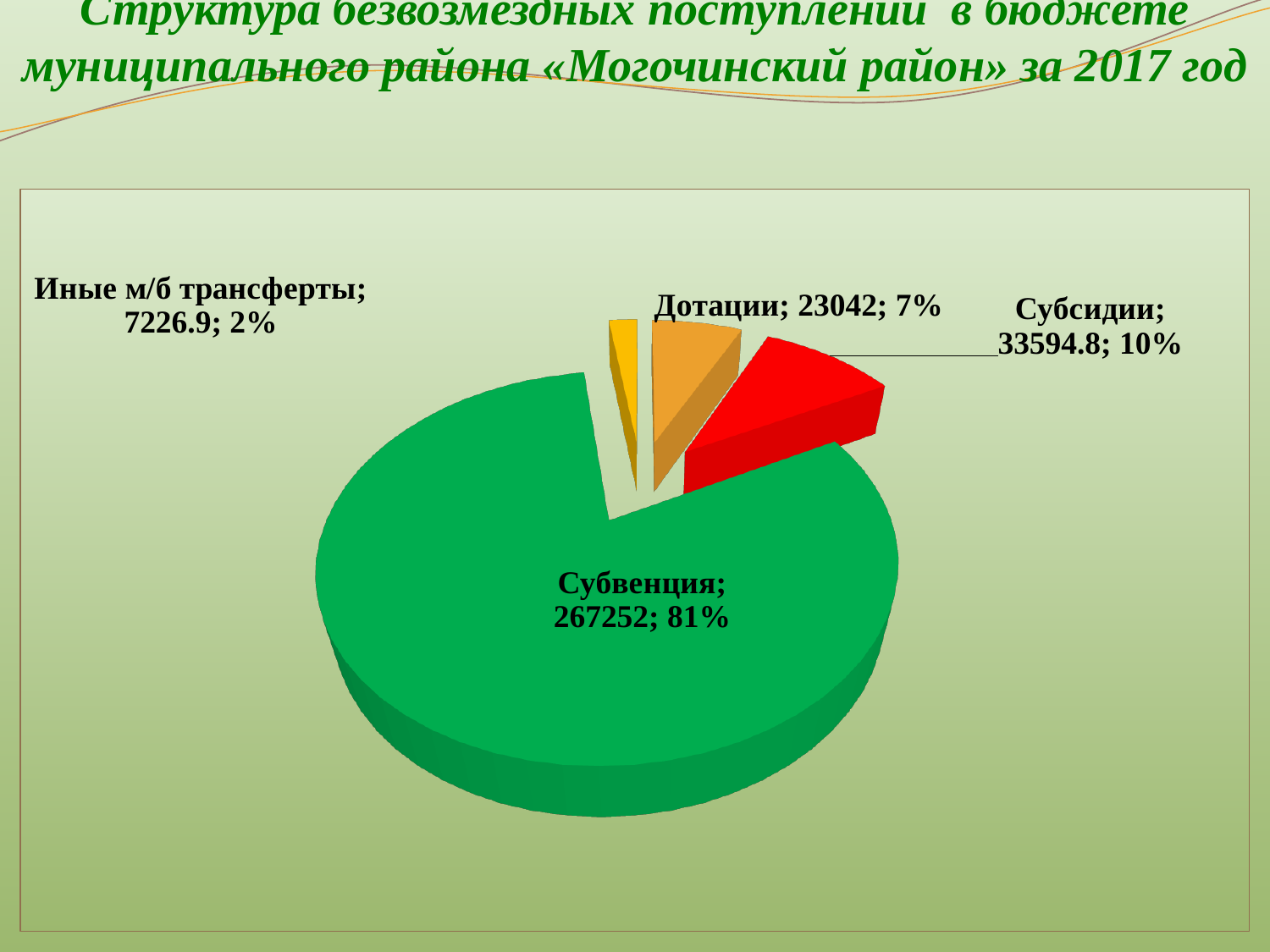
What is the difference between the values for Дотации and Иные м/б трансферты? 15815.1 What is the value for Иные м/б трансферты? 7226.9 What share of the pie does Субсидии represent? 10% What is the value for Дотации? 23042 What kind of chart is shown on the slide? pie chart How many slices does the pie chart have? 4 What share of the pie does Дотации represent? 7% Which category has the largest share of the pie? Субвенция Which category has the smallest share of the pie? Иные м/б трансферты What is the value for Субвенция? 267252 Which is larger, the value for Субсидии or the value for Дотации? Субсидии What is the value for Субсидии? 33594.8